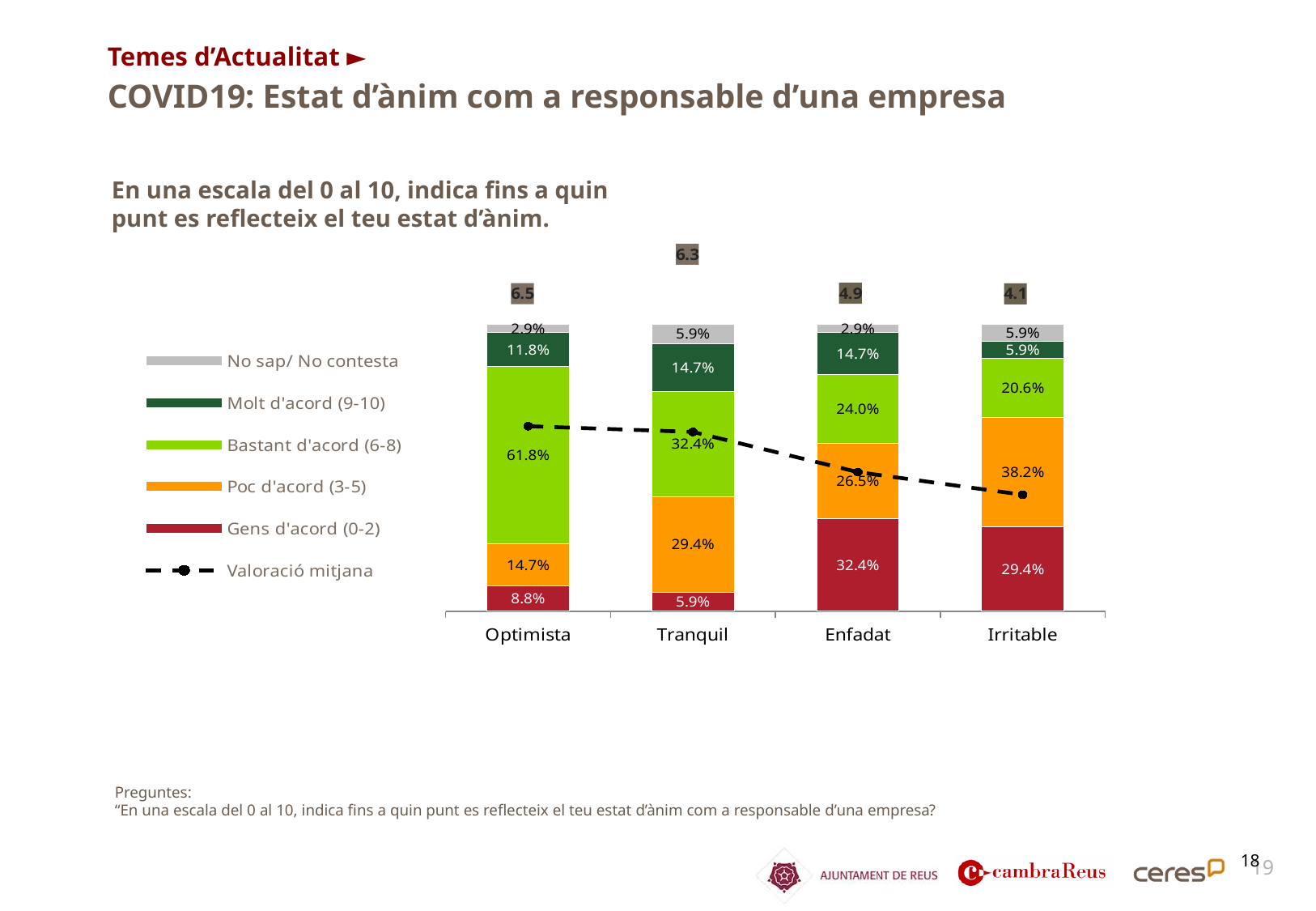
Does the Valoració mitjana line rise or fall from Optimista to Irritable? Fall How many categories are shown on the x axis? 4 What is the Gens d'acord (0-2) percentage for Enfadat? 32.4% Which category has the lowest Valoració mitjana? Irritable What is the Valoració mitjana value for Irritable? 4.1 What is the Valoració mitjana value for Optimista? 6.5 What type of chart is shown on the slide? Stacked bar chart with a line What is the difference between the Poc d'acord (3-5) percentages for Irritable and Optimista? 23.5% What is the Poc d'acord (3-5) percentage for Irritable? 38.2% Which category has the highest Valoració mitjana? Optimista What is the Bastant d'acord (6-8) percentage for Optimista? 61.8% How many series does the legend list? 6